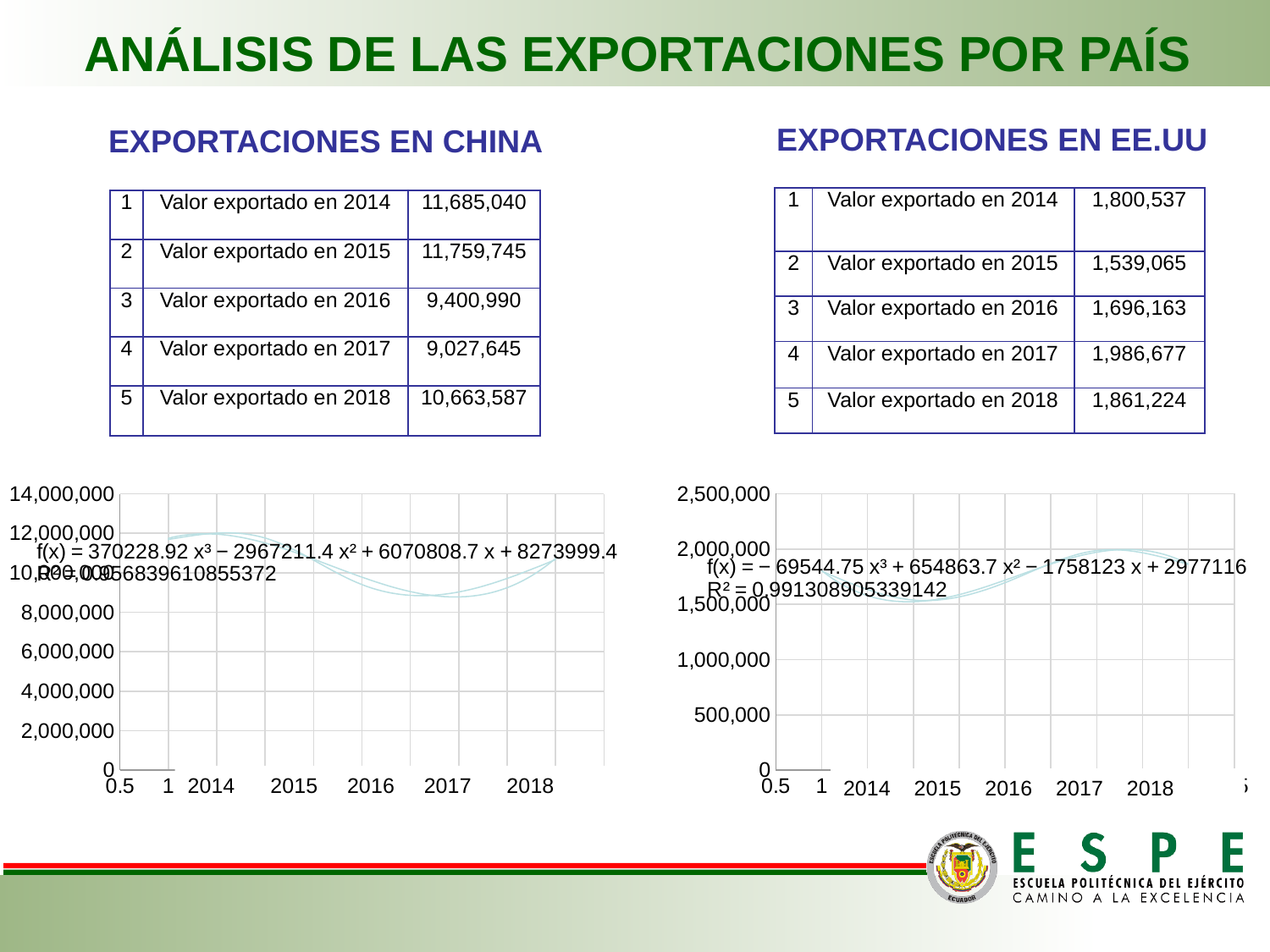
What kind of chart is the 'Exportaciones en China' chart? line chart In the 'Exportaciones en China' chart, do the values rise or fall from 2015 to 2017? fall What R² value is shown on the 'Exportaciones en EE.UU' chart? 0.991308905339142 In the 'Exportaciones en China' chart, how many years are plotted along the x axis? 5 In the 'Exportaciones en China' chart, which year has the lowest exported value? 2017 In the 'Exportaciones en China' chart, what is the value exported in 2014? 11,685,040 In the 'Exportaciones en EE.UU' chart, which year has the highest exported value? 2017 In the 'Exportaciones en China' chart, is the value for 2016 greater or less than 10,000,000? less In the 'Exportaciones en China' chart, what is the difference between the value exported in 2014 and in 2016? 2,284,050 In the 'Exportaciones en EE.UU' chart, which year has the lowest exported value? 2015 In the 'Exportaciones en EE.UU' chart, is the value for 2017 greater or less than 1,500,000? greater In the 'Exportaciones en EE.UU' chart, which is larger, the value exported in 2014 or in 2015? 2014